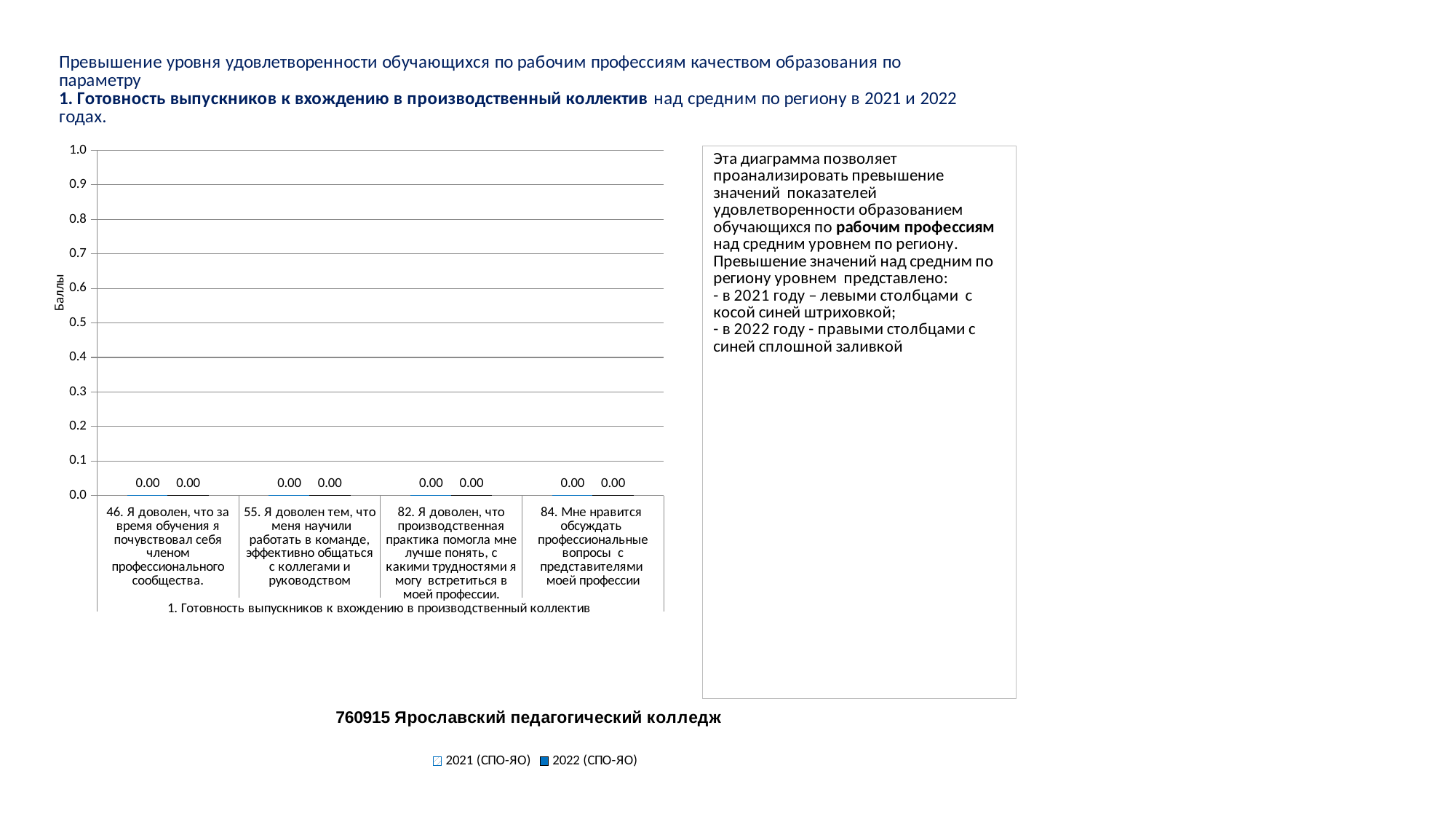
Is the value for 2022 (СПО-ЯО) for category 84 greater or less than 0.1? less How many series does the chart legend list? 2 What is the value for 2021 (СПО-ЯО) for category 82 (Я доволен, что производственная практика помогла мне лучше понять, с какими трудностями я могу встретиться в моей профессии)? 0.00 What is the difference between the 2021 (СПО-ЯО) and 2022 (СПО-ЯО) values for category 46? 0.00 What are the two series named in the chart legend? 2021 (СПО-ЯО) and 2022 (СПО-ЯО) What is the highest value shown on the vertical axis of the chart? 1.0 What kind of chart is shown on the slide? bar chart What is the value for 2021 (СПО-ЯО) for category 46 (Я доволен, что за время обучения я почувствовал себя членом профессионального сообщества)? 0.00 What is the value for 2022 (СПО-ЯО) for category 55 (Я доволен тем, что меня научили работать в команде, эффективно общаться с коллегами и руководством)? 0.00 How many categories are shown on the x axis of the chart? 4 What is the value for 2022 (СПО-ЯО) for category 84 (Мне нравится обсуждать профессиональные вопросы с представителями моей профессии)? 0.00 What is the label of the vertical axis of the chart? Баллы